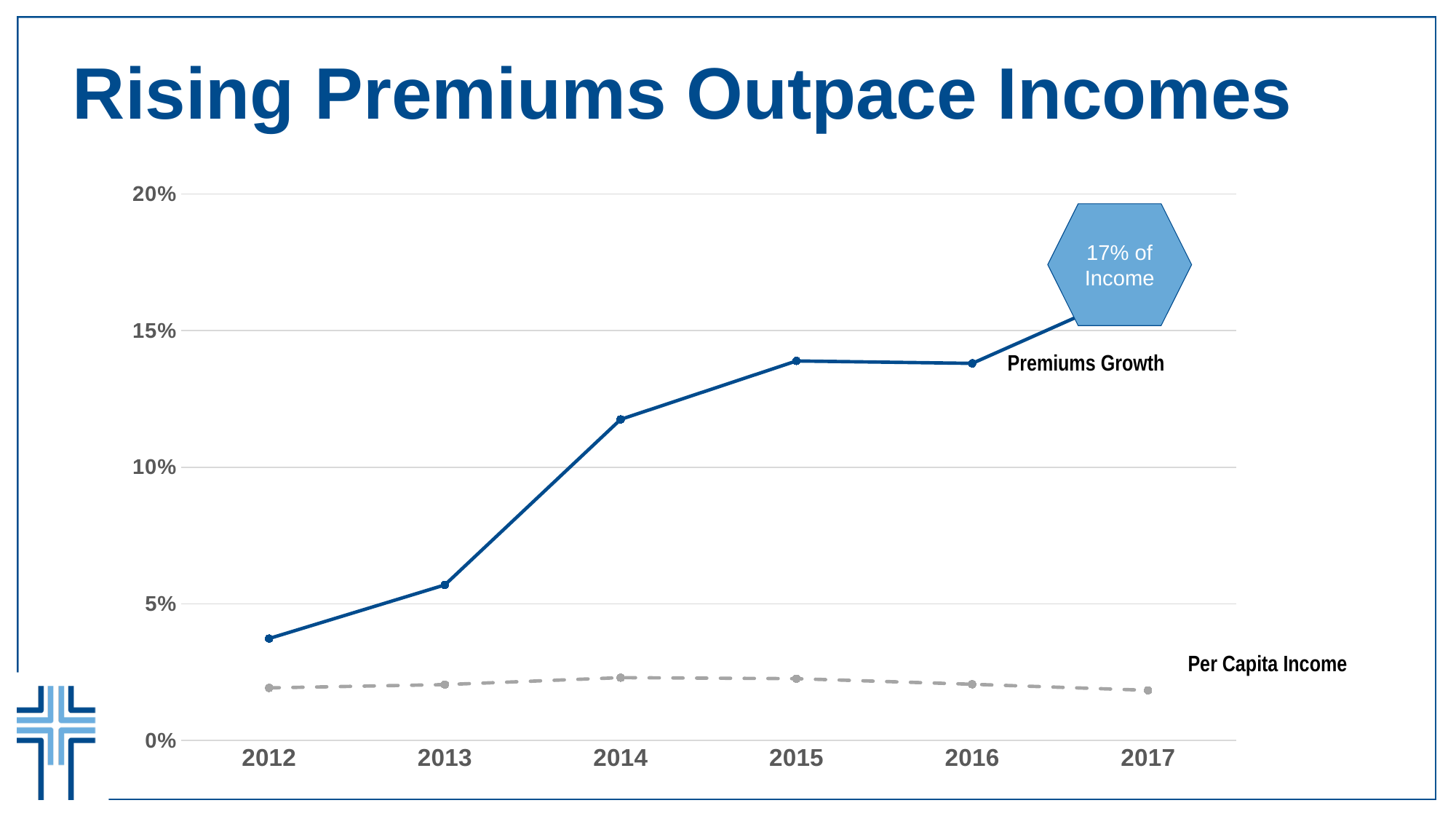
Is the Premiums Growth value for 2015 greater or less than 15%? less Is the Per Capita Income value for 2014 greater or less than 5%? less Is the Premiums Growth value for 2014 greater or less than 10%? greater In which year is Premiums Growth at its highest? 2017 What kind of chart is shown on the slide? line chart How many series are plotted on the chart? 2 How many years are shown along the x axis of the chart? 6 What text is shown in the hexagon callout near the end of the Premiums Growth line? 17% of Income In 2015, which series has the larger value, Premiums Growth or Per Capita Income? Premiums Growth Does the Premiums Growth line generally rise or fall from 2012 to 2017? rise In which year is Premiums Growth at its lowest? 2012